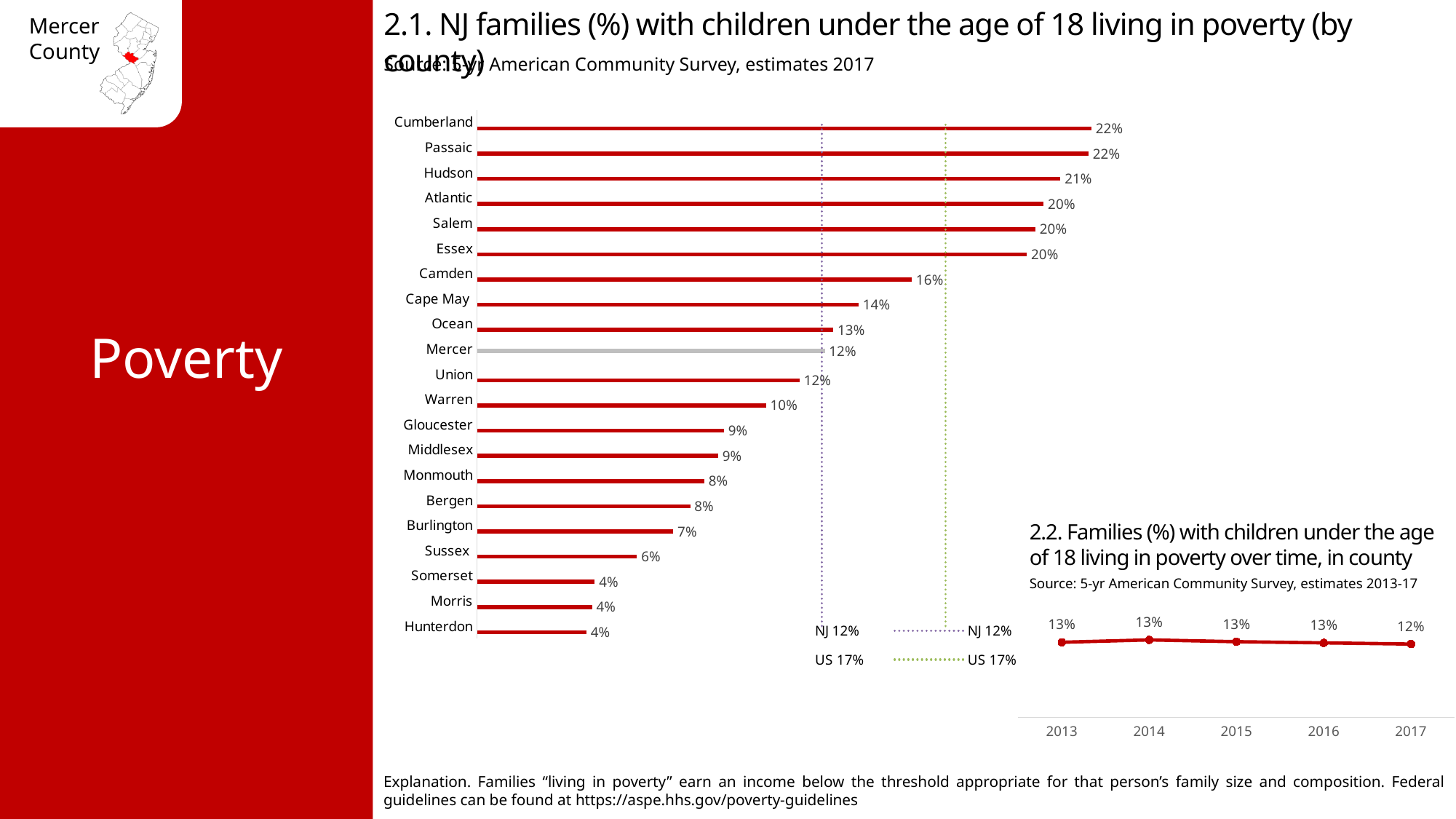
In chart 2.2, what is the value for 2014? 13% In chart 2.1, what percentage is shown for Camden? 16% In chart 2.1, what US reference value is marked by the dotted line? 17% In chart 2.1 (NJ families with children under 18 living in poverty by county), what is the value for Mercer? 12% In chart 2.1, how many counties are listed? 21 In chart 2.1, which has a higher value, Cape May or Warren? Cape May In chart 2.2, does the value rise or fall from 2016 to 2017? Fall What kind of chart is chart 2.1? Bar chart In chart 2.1, what is the difference between the values for Cumberland and Mercer? 10% In chart 2.2 (families with children under 18 living in poverty over time, in county), what is the value for 2017? 12% In chart 2.2, how many years are plotted? 5 In chart 2.1, what is the value for Hudson? 21%